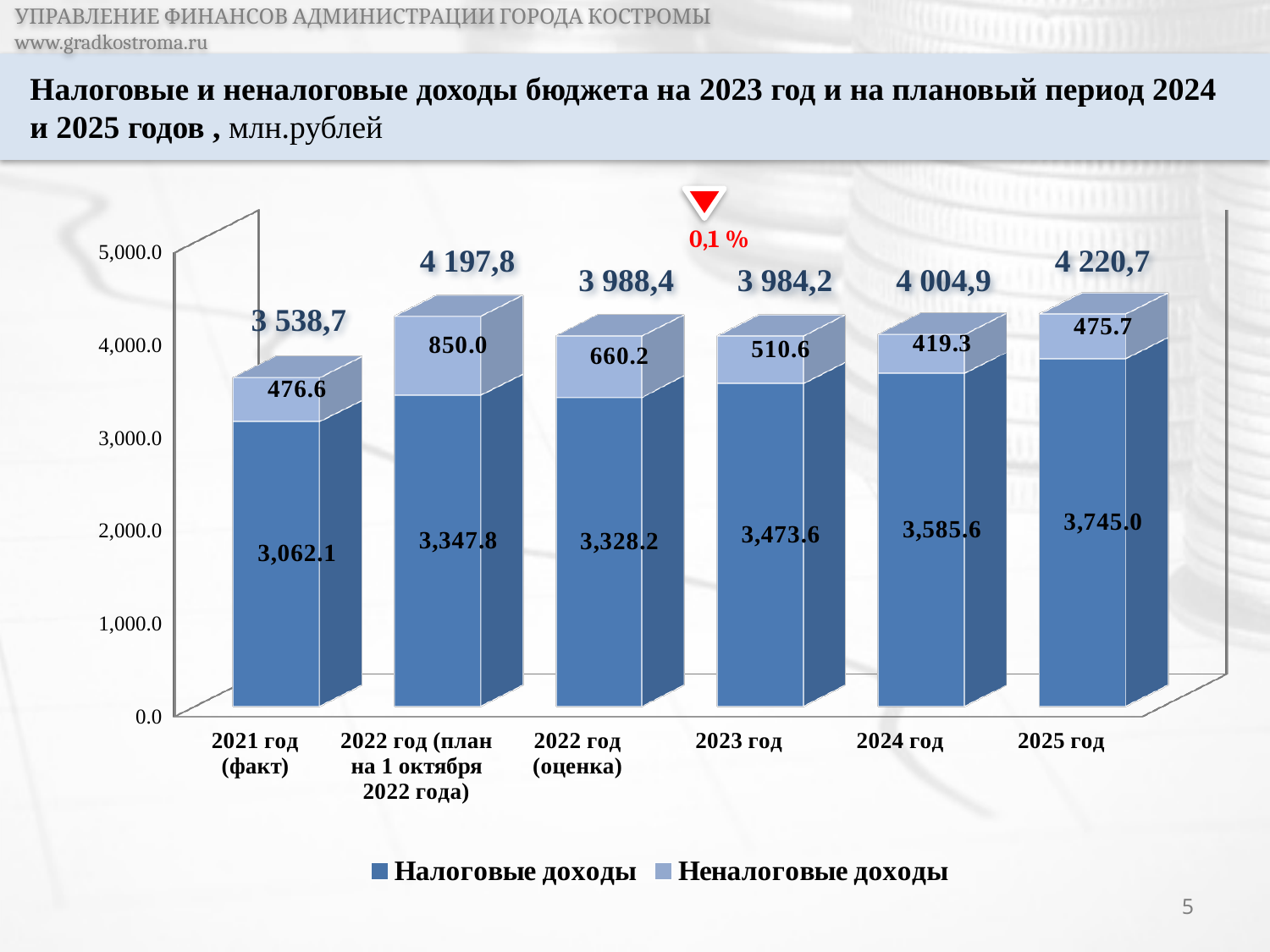
What is the value of Налоговые доходы for 2021 год (факт)? 3,062.1 Which category has the lowest value of Неналоговые доходы? 2024 год Which category has the highest value of Налоговые доходы? 2025 год What is the total shown above the stacked bar for 2025 год? 4 220,7 What kind of chart is shown on the slide? Stacked bar chart How many categories are shown on the x axis? 6 How many series does the legend list? 2 Do the values of Налоговые доходы rise or fall from 2023 год to 2025 год? Rise What is the difference between Налоговые доходы for 2025 год and 2024 год? 159.4 Which is larger: Неналоговые доходы for 2023 год or for 2022 год (оценка)? 2022 год (оценка) What is the value of Неналоговые доходы for 2022 год (план на 1 октября 2022 года)? 850.0 What is the value of Неналоговые доходы for 2024 год? 419.3